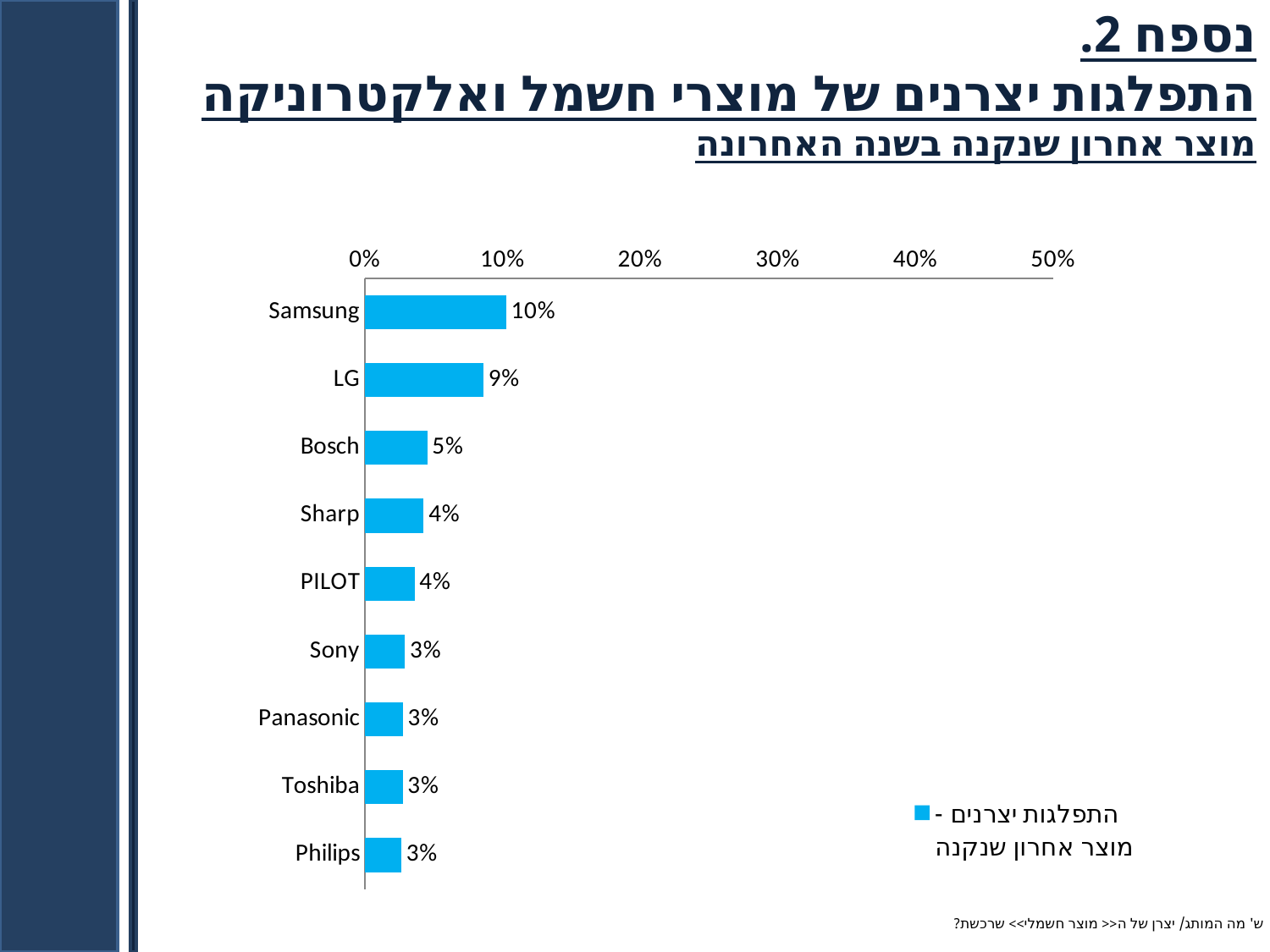
Which brand has the highest value? Samsung Which is larger, the value for Bosch or the value for Sony? Bosch What is the difference between the values for LG and Bosch? 4% Is the value for Samsung greater or less than 20%? less How many brands are shown in the chart? 9 What kind of chart is shown on the slide? bar chart How many series does the legend list? 1 What is the value for Bosch? 5% What is the difference between the values for Samsung and LG? 1% What is the value for Samsung? 10% What is the value for Sharp? 4% What is the value for LG? 9%